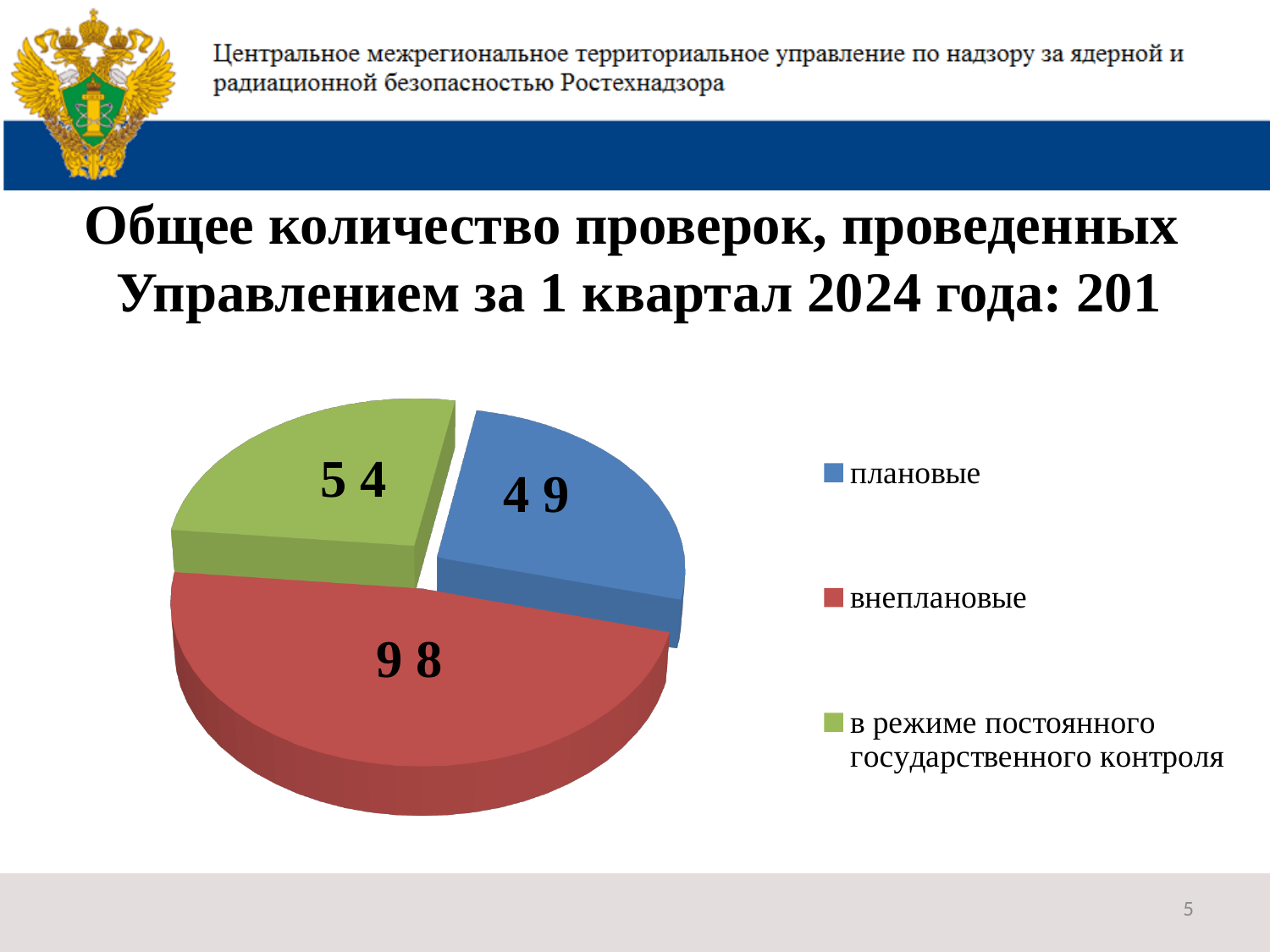
What type of chart is shown on the slide? pie chart What is the total of all slices in the pie chart? 201 What is the value for в режиме постоянного государственного контроля? 54 How many entries does the legend list? 3 What is the difference between внеплановые and плановые? 49 What is the value for плановые? 49 Which is larger, в режиме постоянного государственного контроля or плановые? в режиме постоянного государственного контроля How many slices does the pie chart have? 3 Which category has the smallest slice? плановые What is the value for внеплановые? 98 Which category has the largest slice? внеплановые Which colour represents внеплановые in the pie chart? red